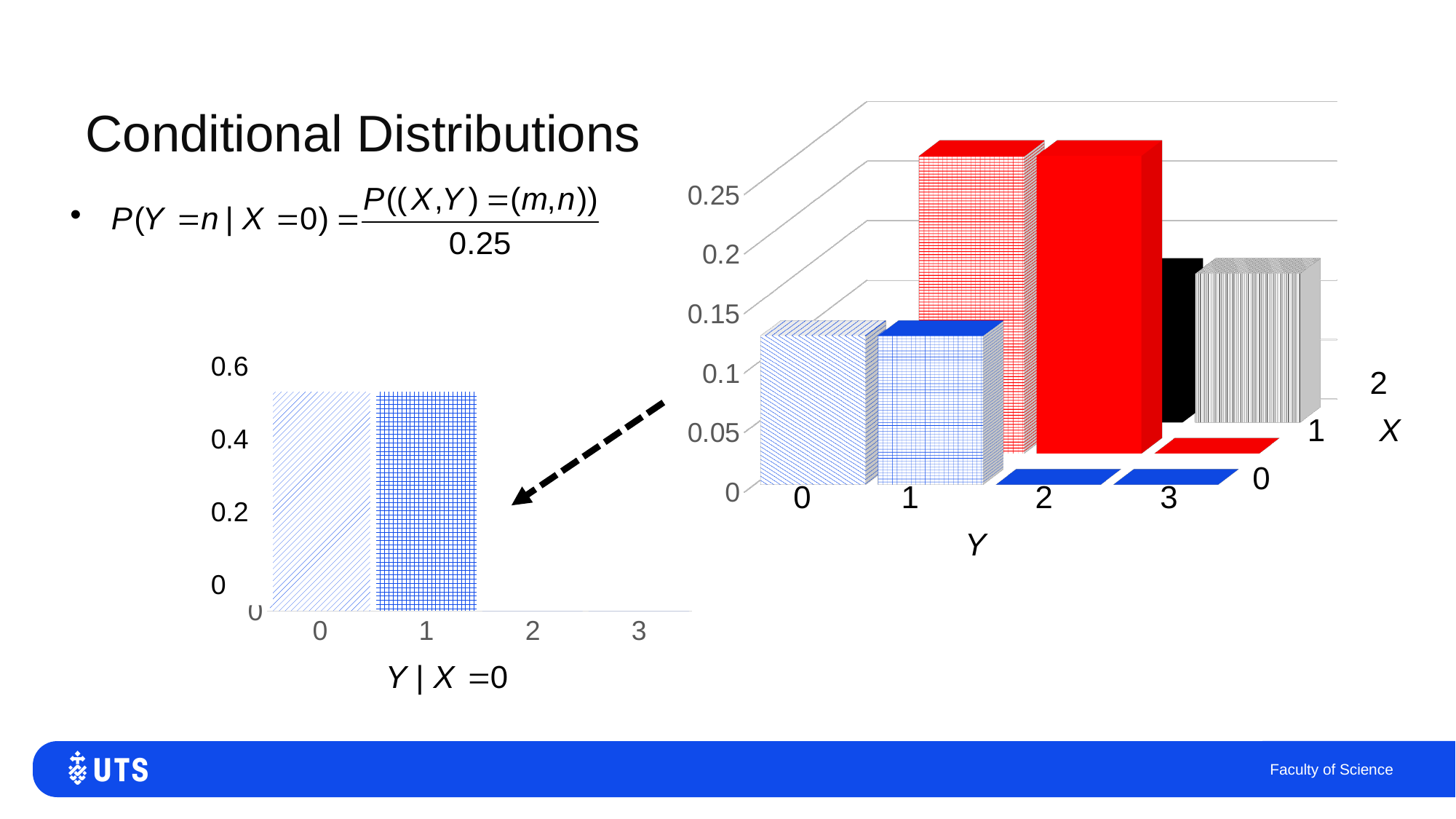
In the left chart "Y | X = 0", is the value for category 0 greater or less than 0.4? greater In the left chart "Y | X = 0", how many categories are shown on the horizontal axis? 4 In the right chart, what is the highest value labelled on the vertical axis? 0.25 In the right chart, is the value for Y = 0 at X = 0 greater or less than 0.2? less What kind of chart is the chart on the right of the slide? bar chart In the right chart, is the value for Y = 1 at X = 0 greater or less than 0.05? greater What kind of chart is the chart on the left titled "Y | X = 0"? bar chart In the left chart "Y | X = 0", what is the highest value shown on the vertical axis? 0.6 In the right chart, how many categories are shown on the X axis? 3 In the right chart, how many categories are shown on the Y axis? 4